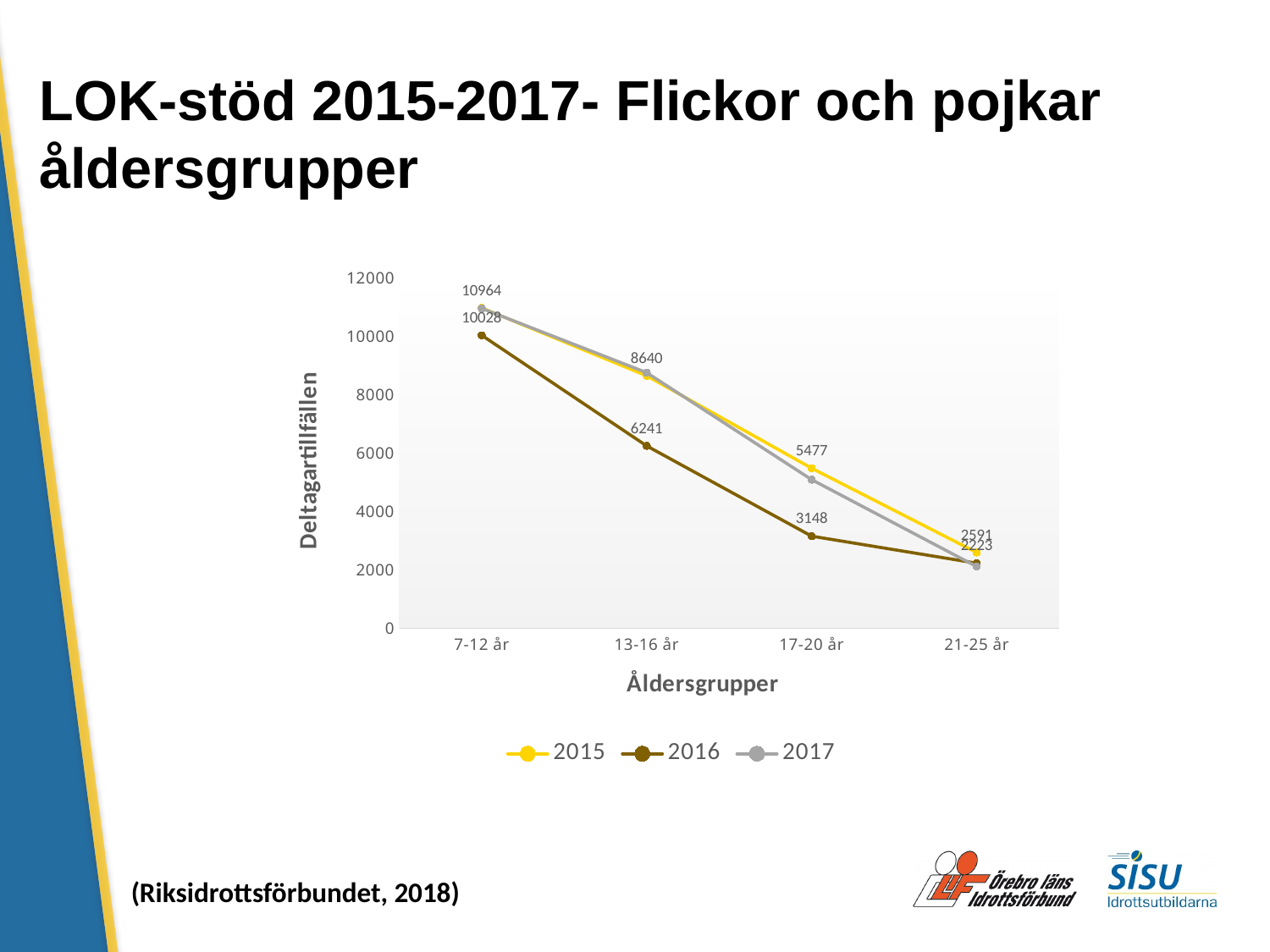
Do the values for the 2016 series rise or fall from 7-12 år to 21-25 år? fall In the 17-20 år age group, which series has the larger value, 2015 or 2016? 2015 How many series does the legend list? 3 What is the value for 2015 in the 17-20 år age group? 5477 What is the difference between the 2016 values for 7-12 år and 13-16 år? 3787 What is the value for 2016 in the 13-16 år age group? 6241 What is the value for 2016 in the 7-12 år age group? 10028 How many age groups are shown on the x axis? 4 Which age group has the highest value for the 2016 series? 7-12 år What is the value for 2016 in the 17-20 år age group? 3148 What kind of chart is shown on the slide? line chart Is the value for 2017 in the 17-20 år age group greater or less than 6000? less